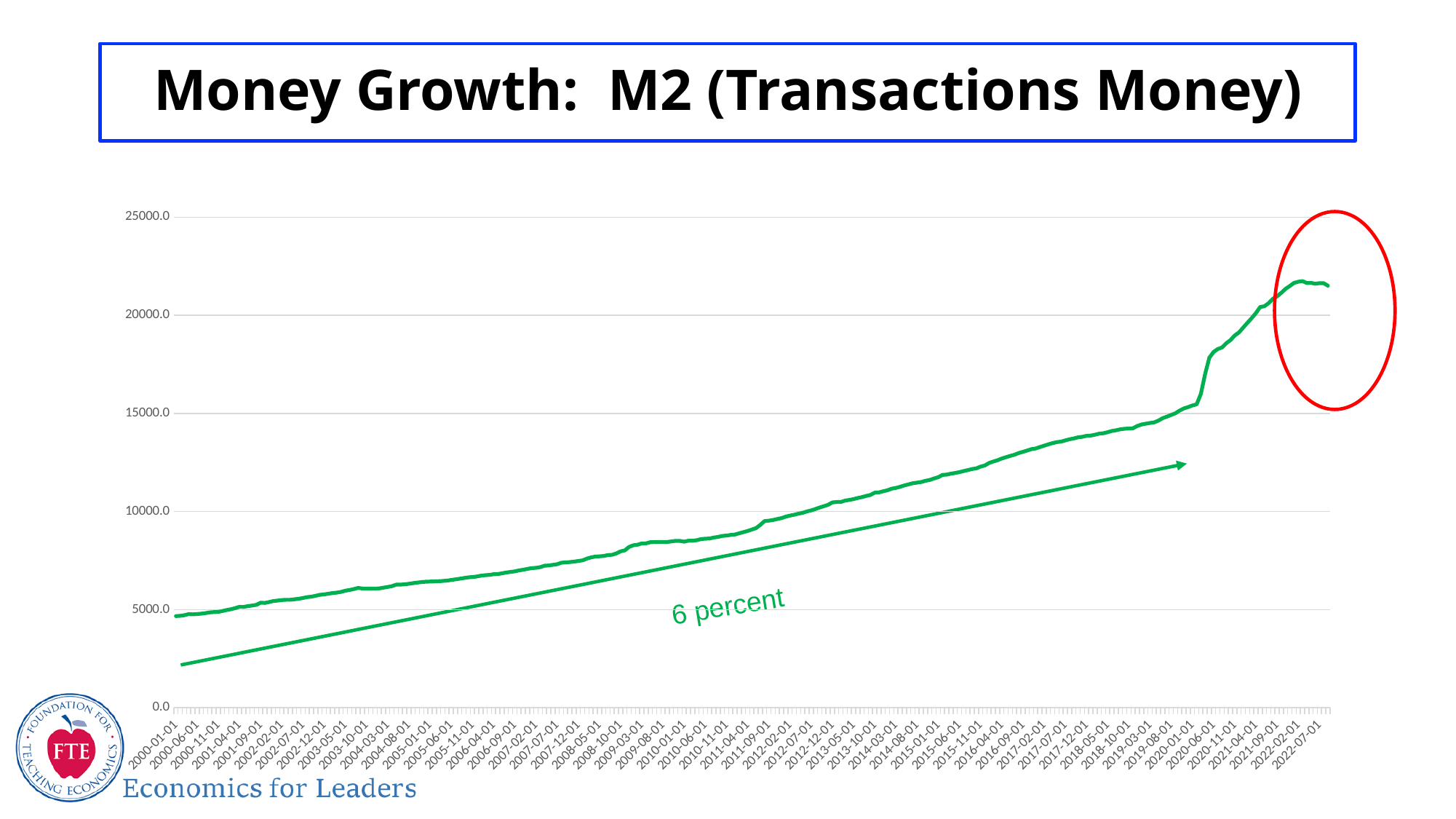
At which date on the x axis is the M2 value lowest? 2000-01-01 Which is larger, the M2 value at 2010-01-01 or at 2020-01-01? 2020-01-01 Is the M2 value at 2000-01-01 greater or less than 5000.0? less What is the title of the slide's chart? Money Growth: M2 (Transactions Money) Is the M2 value at 2005-01-01 greater or less than 5000.0? greater Is the M2 value at 2022-02-01 greater or less than 20000.0? greater What growth rate is written next to the straight trend arrow on the chart? 6 percent What kind of chart is shown on the slide? line chart Do the M2 values generally rise or fall from 2000-01-01 to 2022-07-01? rise